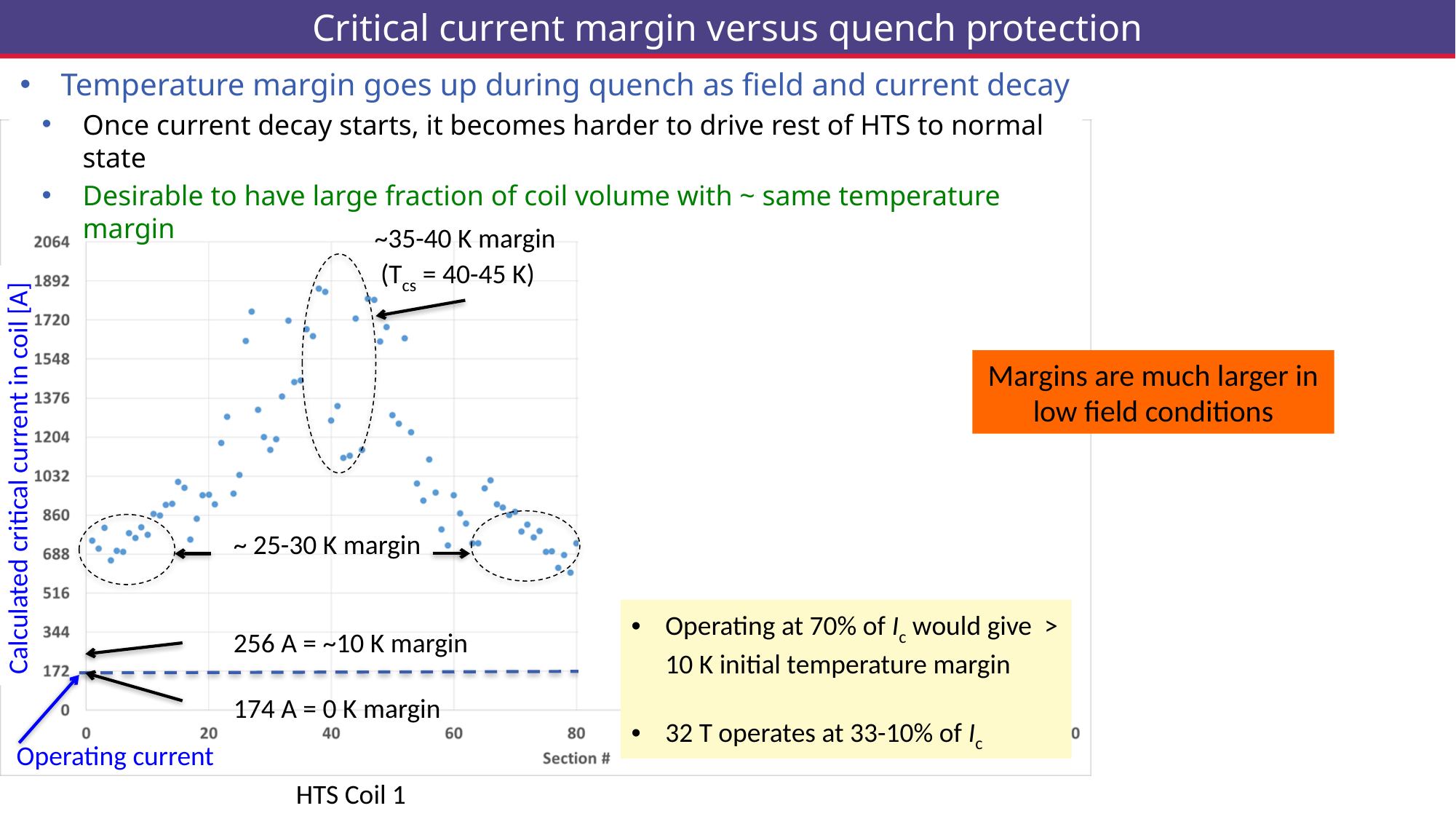
According to the annotation, what current corresponds to a ~10 K margin? 256 A What is the label of the x-axis of the chart? Section # Which coil does the chart show data for? HTS Coil 1 Are the plotted values near section 0 greater or less than 860? less Is the highest plotted critical current value greater or less than 1720? greater Do the plotted values generally rise or fall from section 0 to section 40? rise What is the highest tick value shown on the y-axis? 2064 According to the annotation, what current corresponds to a 0 K margin? 174 A What is the label of the y-axis of the chart? Calculated critical current in coil [A] Do the plotted values generally fall or rise from section 40 to section 80? fall What kind of chart is shown on the slide? Scatter chart Are the plotted values near section 80 greater or less than 1032? less